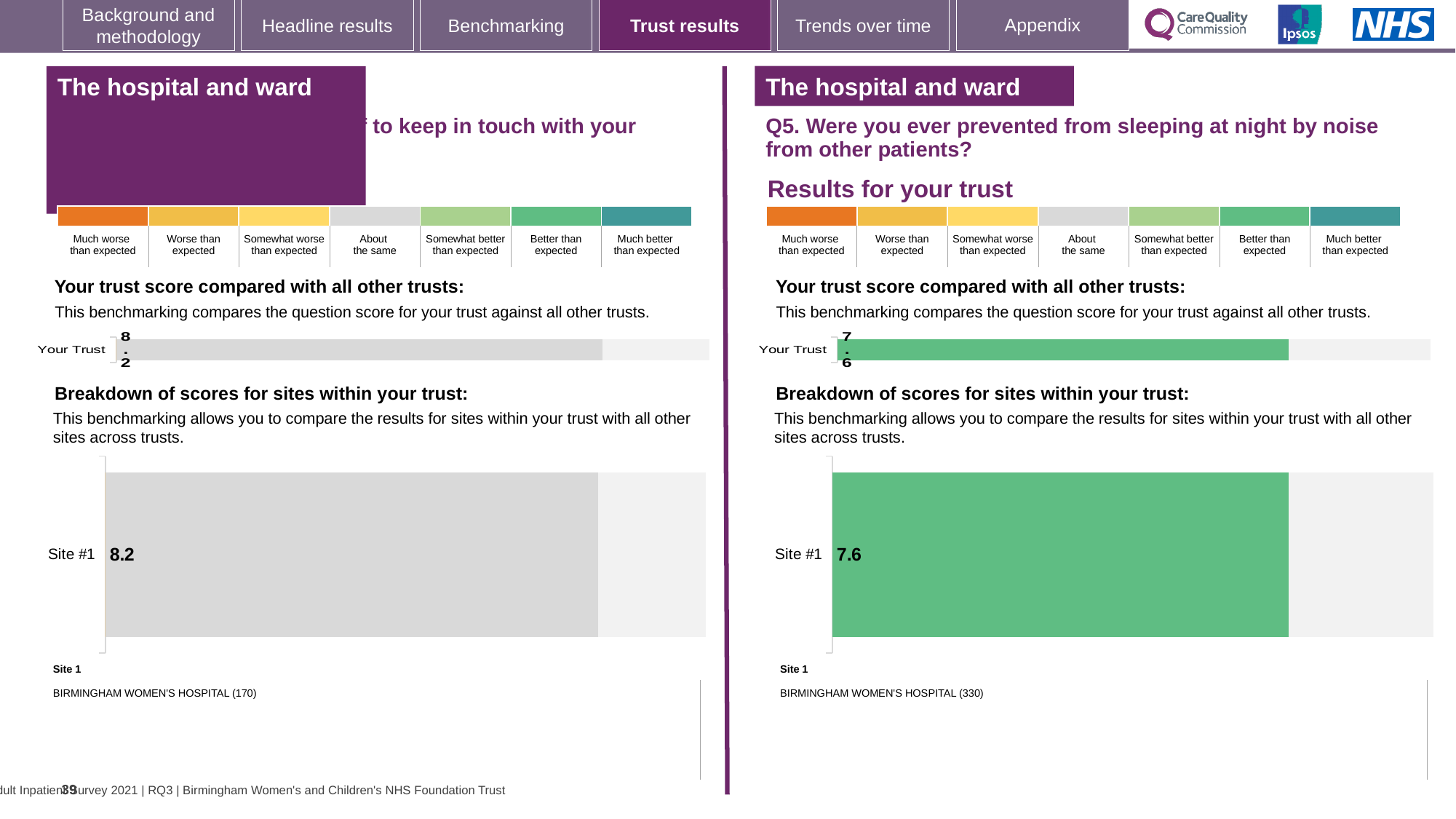
On the right-hand chart for Q5 (prevented from sleeping at night by noise from other patients), what is the score shown for Your Trust? 7.6 How many sites are shown in the left-hand site breakdown chart? 1 What type of chart is used to show the Site #1 score on the right-hand Q5 breakdown? Bar chart On the left-hand site breakdown chart, what is the score for Site #1? 8.2 What is the difference between the Site #1 score on the left-hand chart (8.2) and the Site #1 score on the right-hand Q5 chart (7.6)? 0.6 On the left-hand chart, what is the score shown for Your Trust? 8.2 Which site name is listed as Site 1 under the right-hand Q5 breakdown chart? BIRMINGHAM WOMEN'S HOSPITAL (330) What colour is the Site #1 bar on the left-hand breakdown chart? Grey How many sites are shown in the right-hand Q5 site breakdown chart? 1 What colour is the Site #1 bar on the right-hand Q5 breakdown chart? Green On the right-hand Q5 site breakdown chart, what is the score for Site #1? 7.6 Which is larger: the Site #1 score on the left-hand chart or the Site #1 score on the right-hand Q5 chart? Left-hand chart (8.2)